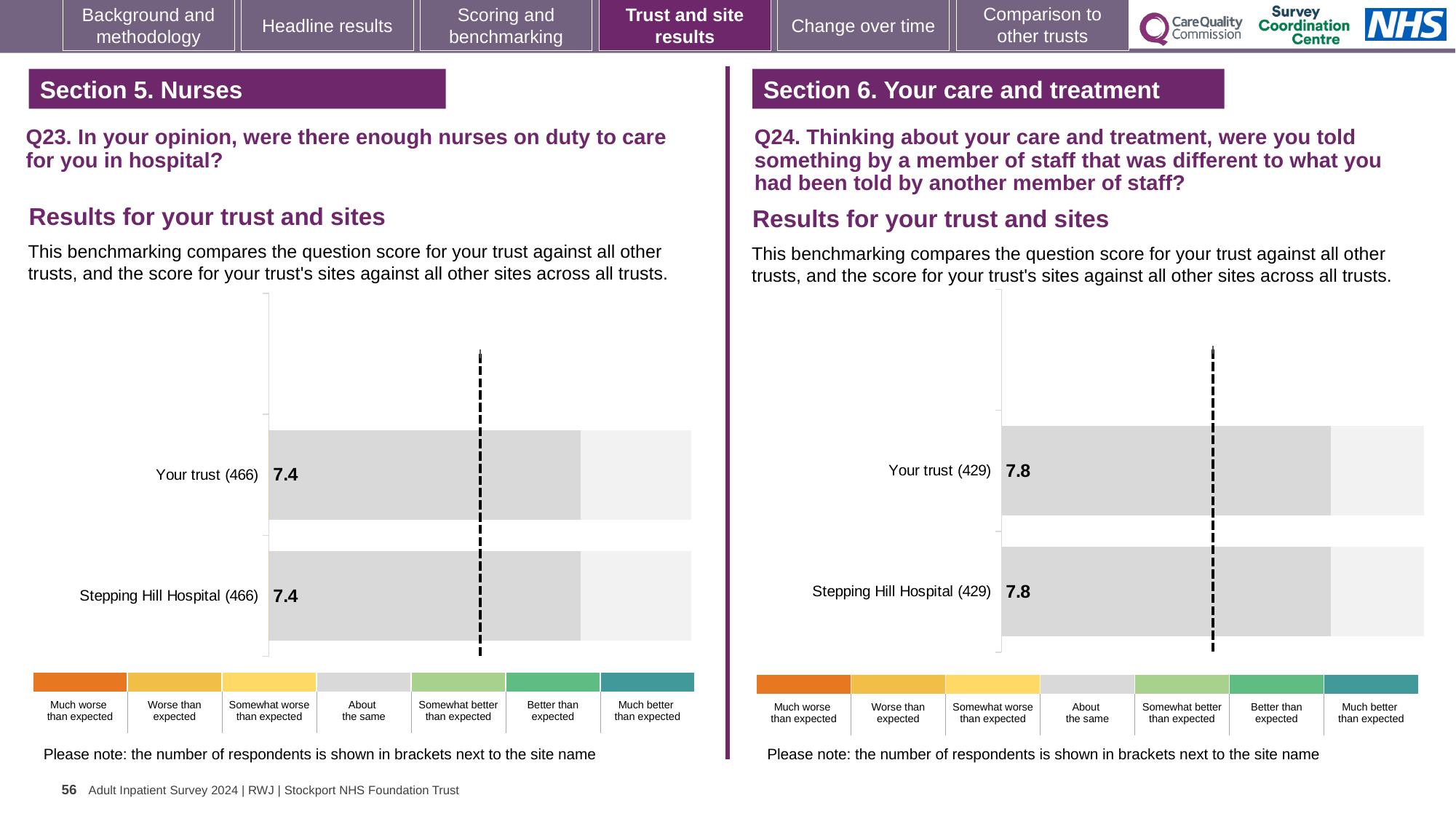
On the Q23 chart (left), how many bars are plotted? 2 On the Q23 chart (left), what is the score for Your trust? 7.4 On the Q23 chart (left), how many respondents are shown in brackets next to Your trust? 466 On the Q24 chart (right), what is the score for Stepping Hill Hospital? 7.8 On the Q24 chart (right), how many respondents are shown in brackets next to Stepping Hill Hospital? 429 On the Q23 chart (left), what is the difference between the score for Your trust and the score for Stepping Hill Hospital? 0 On the Q24 chart (right), how many bars are plotted? 2 What kind of chart is used on the Q23 chart (left)? Bar chart How many colour bands does the key below the Q24 chart (right) show? 7 On the Q24 chart (right), what is the score for Your trust? 7.8 On the Q23 chart (left), what is the score for Stepping Hill Hospital? 7.4 On the Q24 chart (right), what is the difference between the score for Your trust and the score for Stepping Hill Hospital? 0